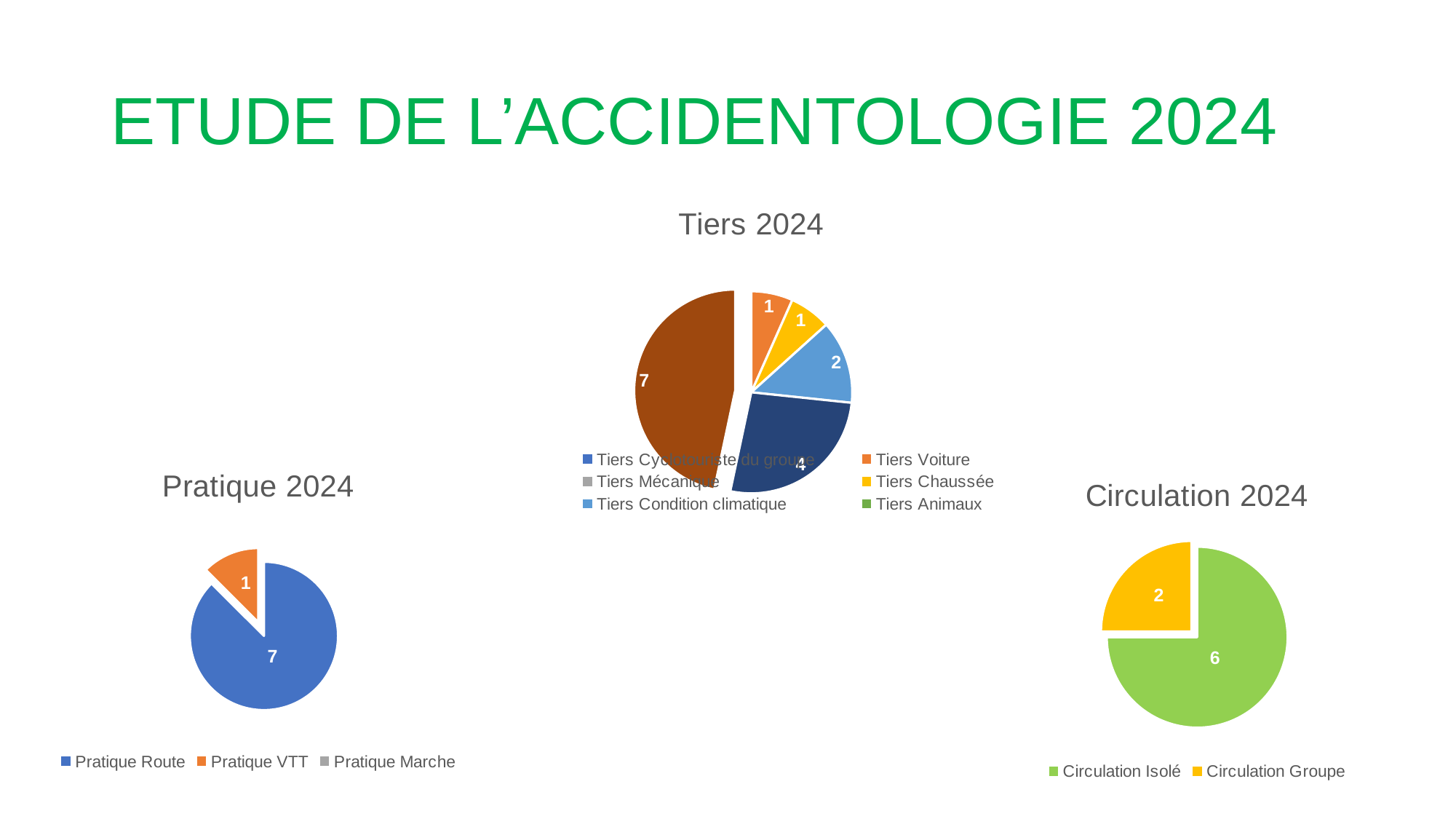
How many entries does the legend of the Pratique 2024 chart list? 3 In the Tiers 2024 chart, what is the value for Tiers Condition climatique? 2 What kind of chart is the Circulation 2024 chart? Pie chart In the Circulation 2024 chart, what is the value for Circulation Groupe? 2 In the Circulation 2024 chart, what is the value for Circulation Isolé? 6 In the Pratique 2024 chart, what is the value for Pratique Route? 7 In the Circulation 2024 chart, what is the difference between Circulation Isolé and Circulation Groupe? 4 In the Tiers 2024 chart, which is larger: Tiers Condition climatique or Tiers Voiture? Tiers Condition climatique In the Circulation 2024 chart, what share of the pie does Circulation Isolé represent? 75% In the Pratique 2024 chart, which category has the largest slice? Pratique Route In the Pratique 2024 chart, what is the value for Pratique VTT? 1